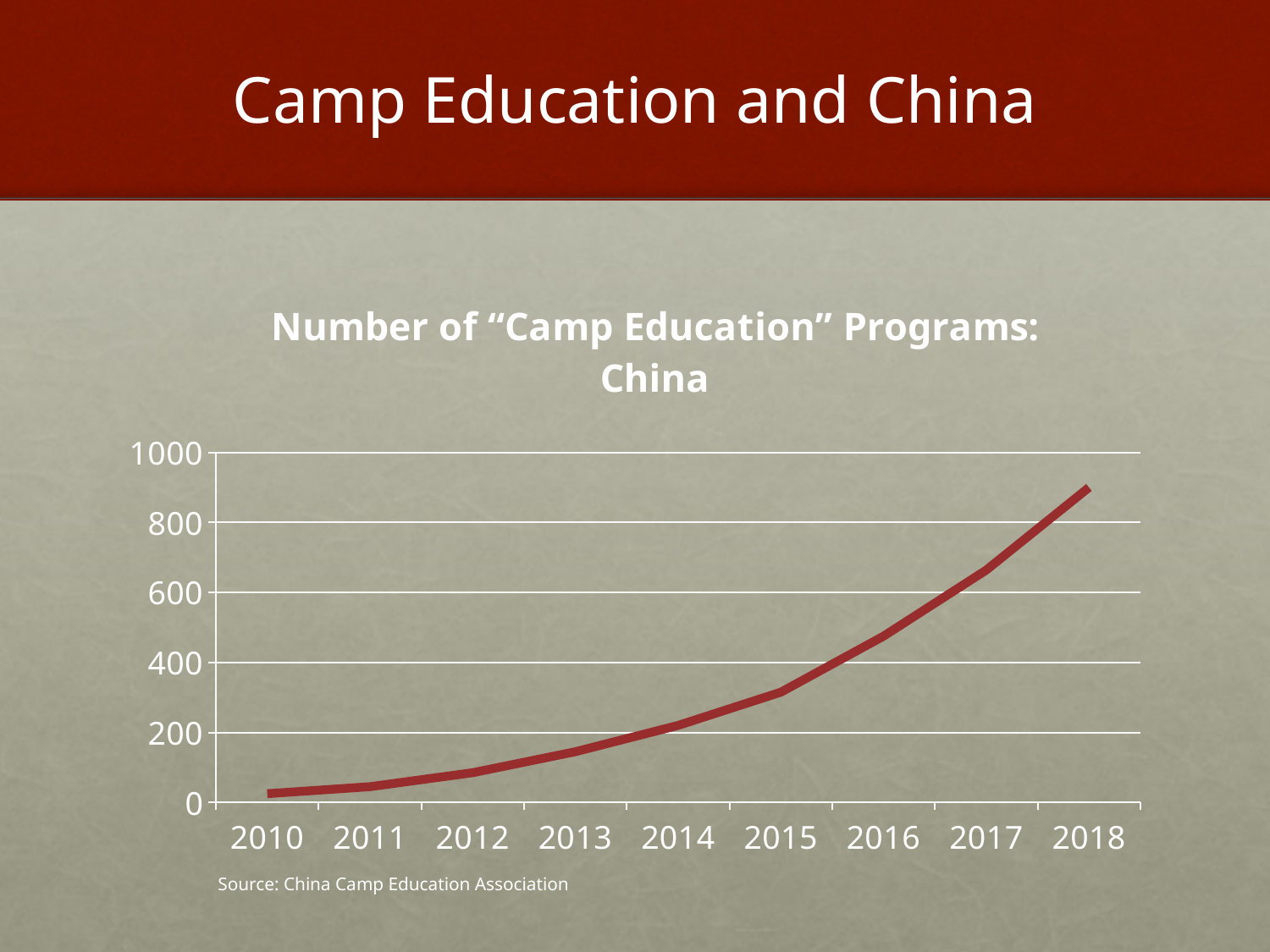
Which year has the lowest number of camp education programs? 2010 Is the value for 2013 greater or less than 200? less Is the value for 2017 greater or less than 600? greater Do the values rise or fall from 2010 to 2018? rise What kind of chart is shown on the slide? line chart What is the title of the chart? Number of "Camp Education" Programs: China Which year has the highest number of camp education programs? 2018 Which year has the larger value, 2014 or 2016? 2016 Is the value for 2018 greater or less than 800? greater What source is cited below the chart? China Camp Education Association How many years are plotted along the x axis? 9